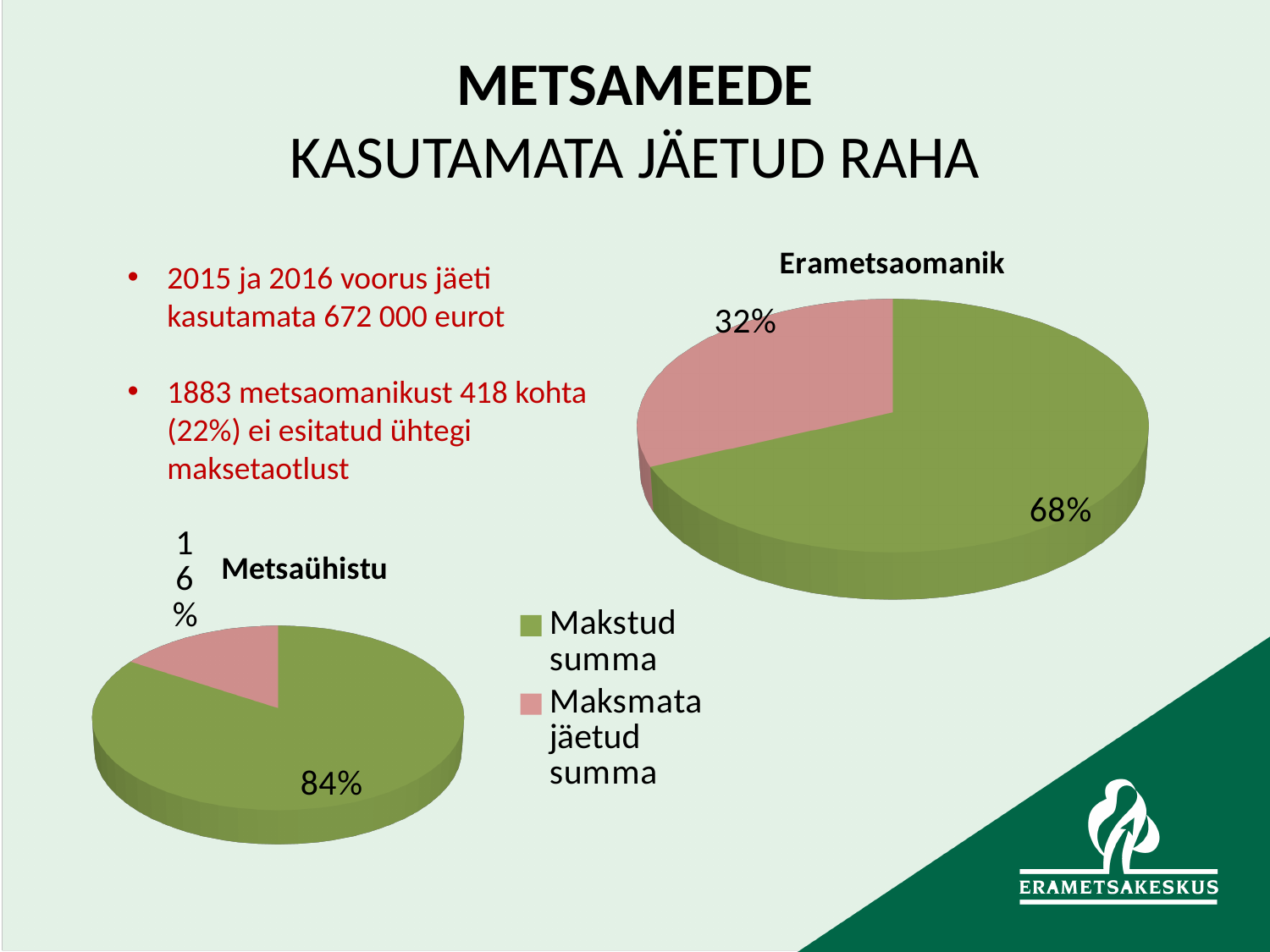
In the "Metsaühistu" chart, what share of the pie is "Maksmata jäetud summa"? 16% How many slices does the "Erametsaomanik" pie chart have? 2 In the "Erametsaomanik" chart, which slice is the largest? Makstud summa In the "Erametsaomanik" chart, what share of the pie is "Maksmata jäetud summa"? 32% In the legend, which colour represents "Maksmata jäetud summa"? Pink In the "Metsaühistu" chart, which slice is the smallest? Maksmata jäetud summa What kind of chart is the "Metsaühistu" chart? Pie chart Which chart has the larger "Maksmata jäetud summa" share, "Erametsaomanik" or "Metsaühistu"? Erametsaomanik In the "Metsaühistu" chart, what share of the pie is "Makstud summa"? 84% In the "Erametsaomanik" chart, what is the difference in percentage points between the "Makstud summa" and "Maksmata jäetud summa" slices? 36 How many entries does the legend on the slide list? 2